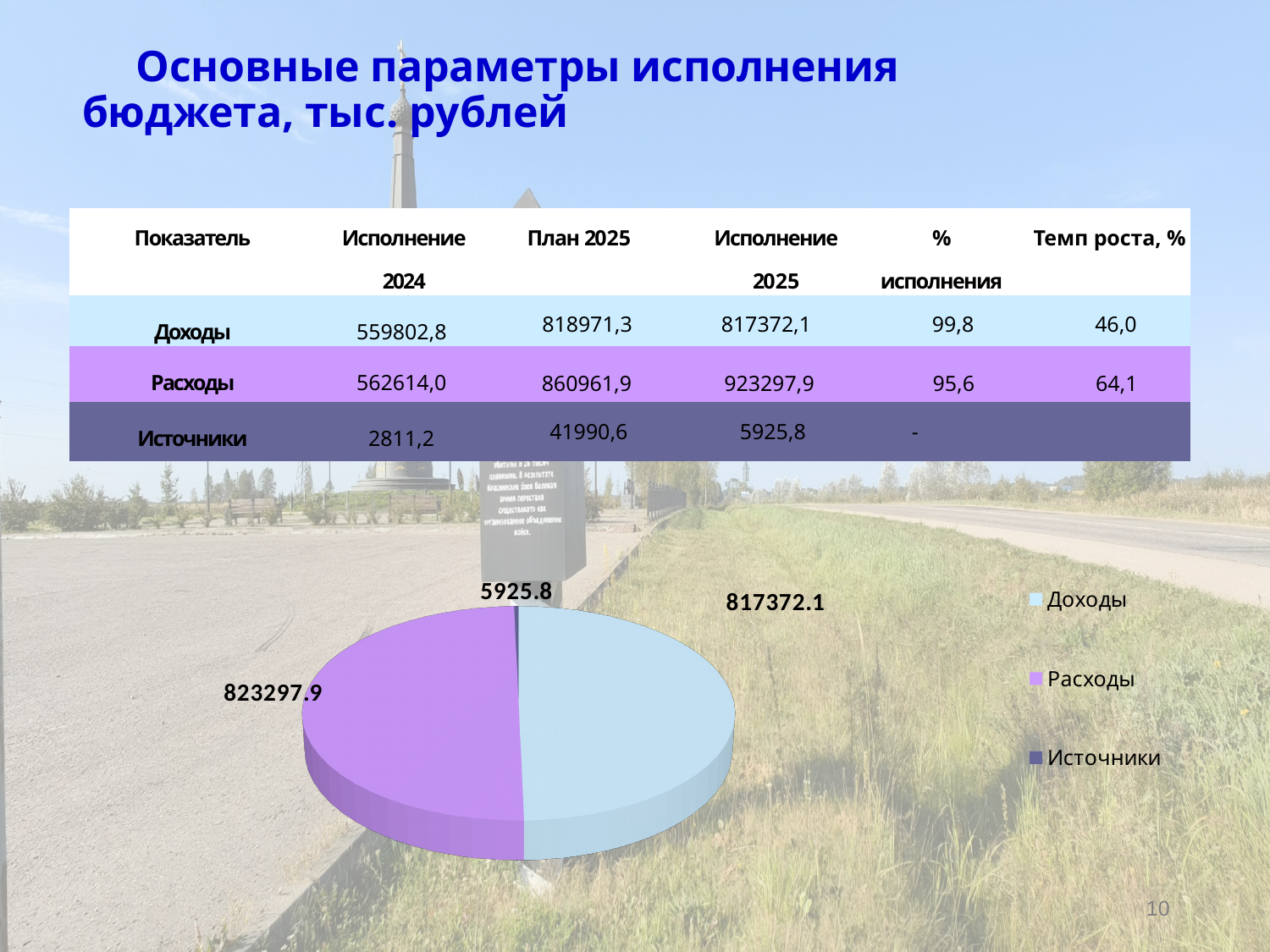
What colour is the Расходы slice in the pie chart? purple What kind of chart is shown on the slide? pie chart Which slice of the pie chart is the smallest? Источники How many entries does the pie chart legend list? 3 In the pie chart, what value is shown for Источники? 5925.8 In the pie chart, which is larger: the value for Доходы or the value for Источники? Доходы Which slice of the pie chart is the largest? Расходы In the pie chart, what value is shown for Расходы? 823297.9 In the pie chart, what is the difference between the values for Расходы and Доходы? 5925.8 In the pie chart, what value is shown for Доходы? 817372.1 How many slices does the pie chart have? 3 What colour is the Доходы slice in the pie chart? light blue